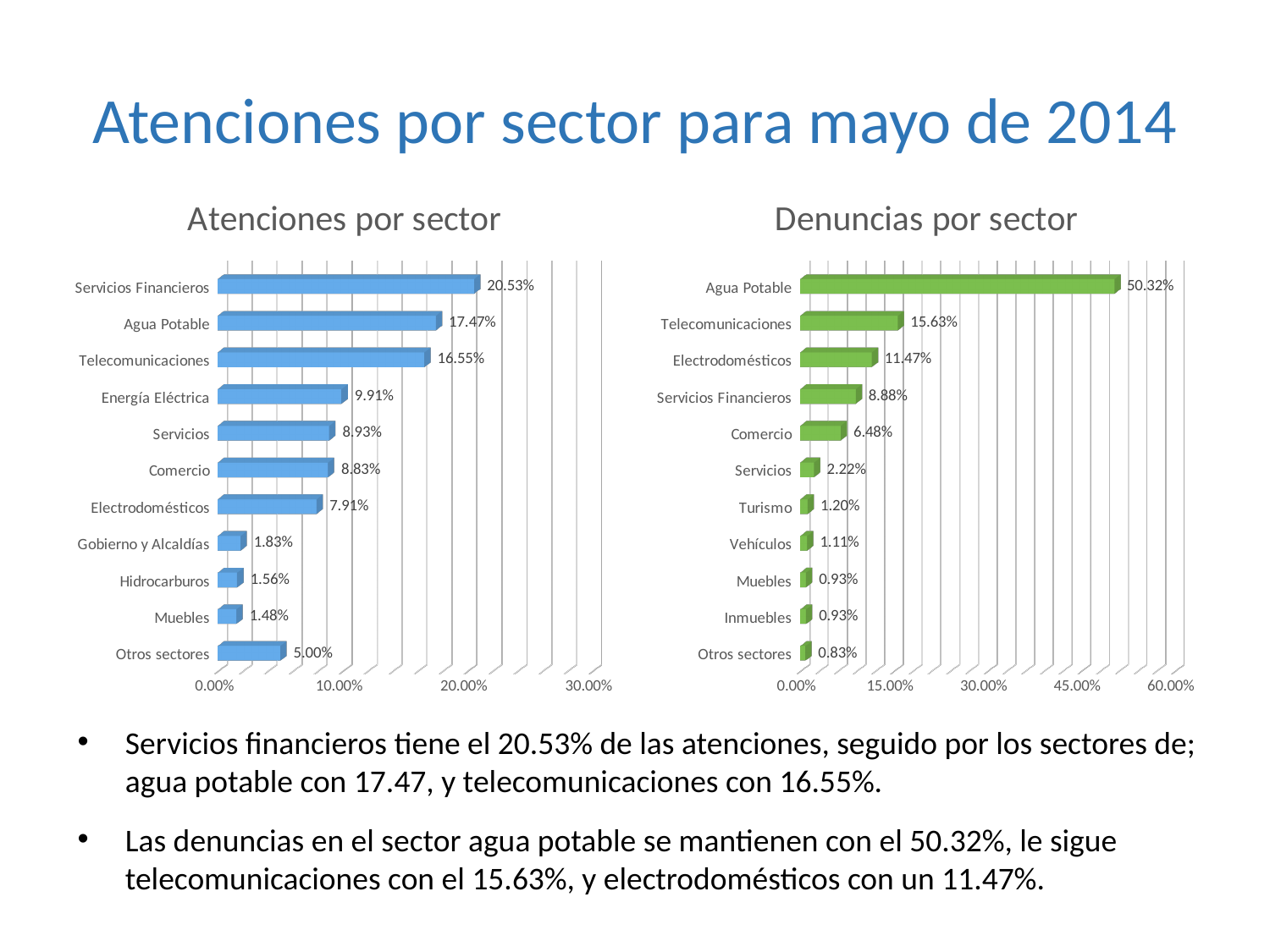
In the 'Denuncias por sector' chart, what is the value for Agua Potable? 50.32% In the 'Atenciones por sector' chart, which category has the lowest value? Muebles What kind of chart is the 'Denuncias por sector' chart? Bar chart In the 'Denuncias por sector' chart, what is the difference between Telecomunicaciones and Electrodomésticos? 4.16% In the 'Denuncias por sector' chart, which category has the highest value? Agua Potable In the 'Denuncias por sector' chart, what is the value for Comercio? 6.48% What colour are the bars in the 'Atenciones por sector' chart? Blue In the 'Atenciones por sector' chart, what is the value for Energía Eléctrica? 9.91% In the 'Denuncias por sector' chart, which is larger, Electrodomésticos or Servicios Financieros? Electrodomésticos In the 'Atenciones por sector' chart, what is the difference between Agua Potable and Telecomunicaciones? 0.92% In the 'Atenciones por sector' chart, what is the value for Servicios Financieros? 20.53% In the 'Atenciones por sector' chart, how many categories are shown? 11